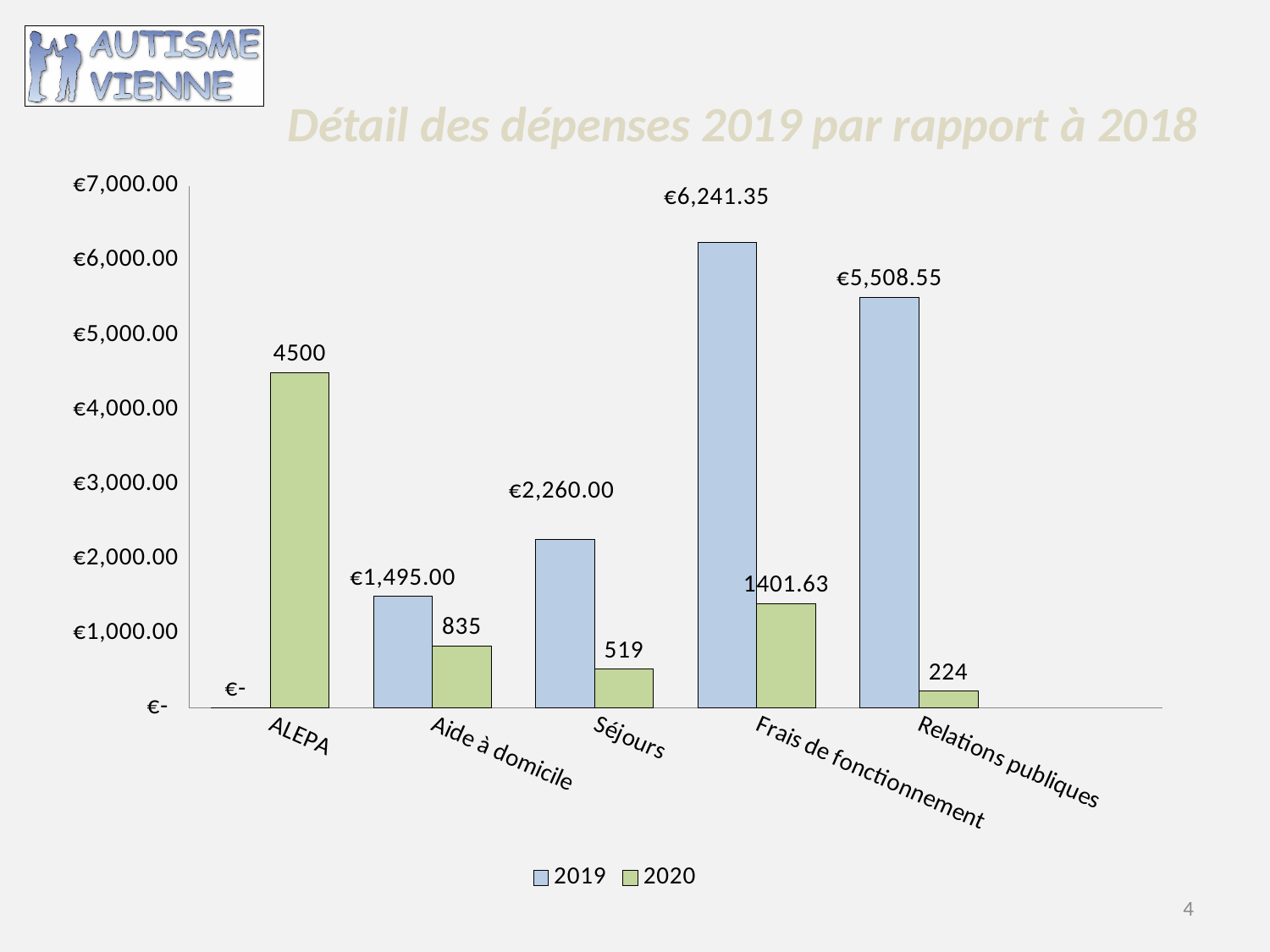
Which category has the highest 2020 value? ALEPA Which category has the lowest 2020 value? Relations publiques Which category has the highest 2019 value? Frais de fonctionnement How many series does the legend list? 2 What kind of chart is shown on the slide? Bar chart Which is larger for Relations publiques, the 2019 value or the 2020 value? 2019 What is the 2020 value for ALEPA? 4500 What is the 2020 value for Relations publiques? 224 What is the difference between the 2019 and 2020 values for Aide à domicile? 660 How many categories are shown on the x axis? 5 What is the 2019 value for Séjours? €2,260.00 What is the 2019 value for Frais de fonctionnement? €6,241.35